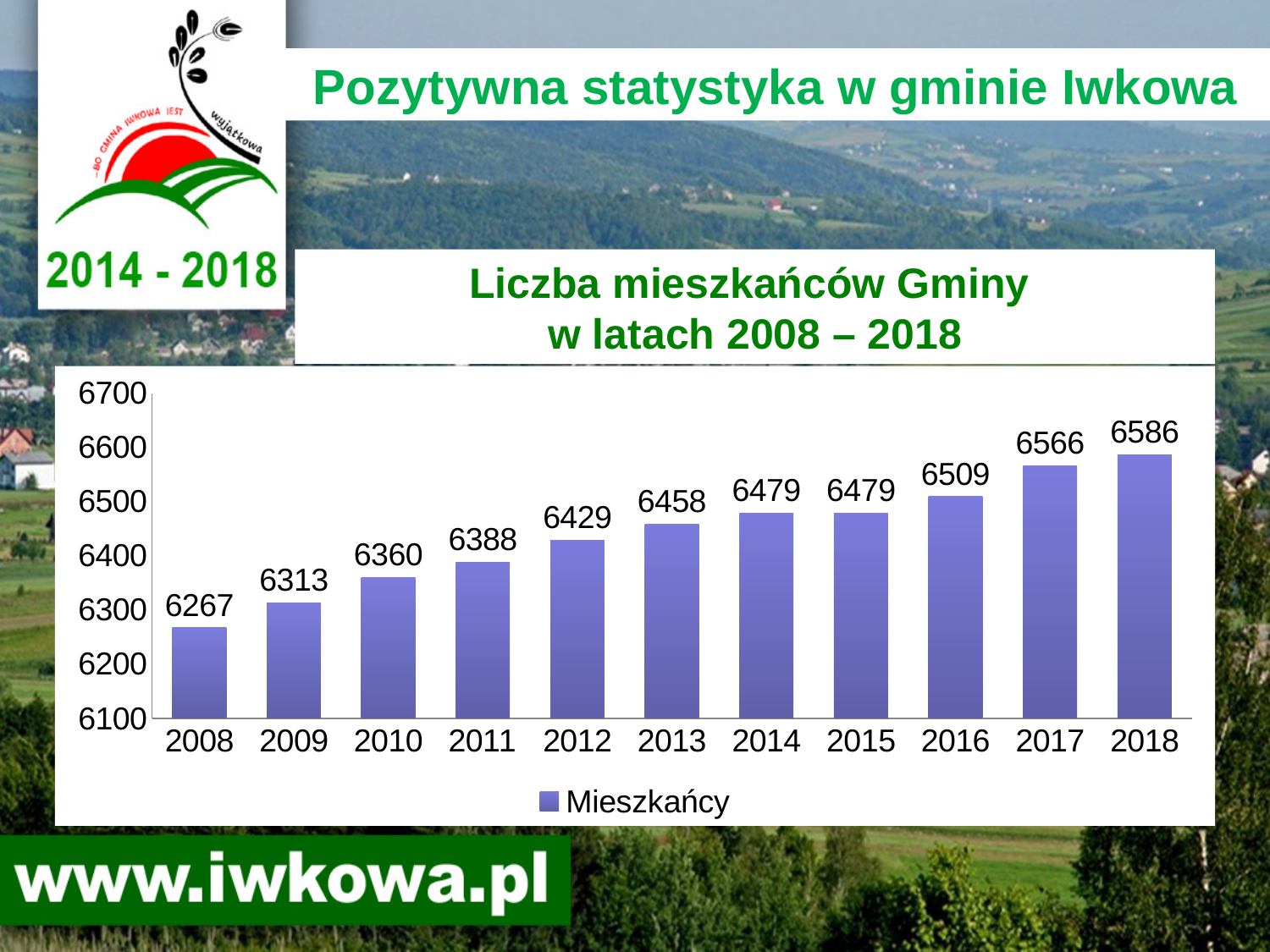
How many series does the chart legend list? 1 Which year has the highest number of residents? 2018 What is the difference between the number of residents in 2017 and in 2016? 57 How many years are shown on the x axis of the chart? 11 Do the values rise or fall from 2008 to 2018? rise What is the difference between the number of residents in 2018 and in 2008? 319 Which year has more residents, 2010 or 2012? 2012 What is the number of residents shown for 2018? 6586 What is the number of residents shown for 2013? 6458 Which year has the lowest number of residents? 2008 What is the number of residents (Mieszkańcy) in 2008? 6267 What kind of chart is shown on the slide? bar chart